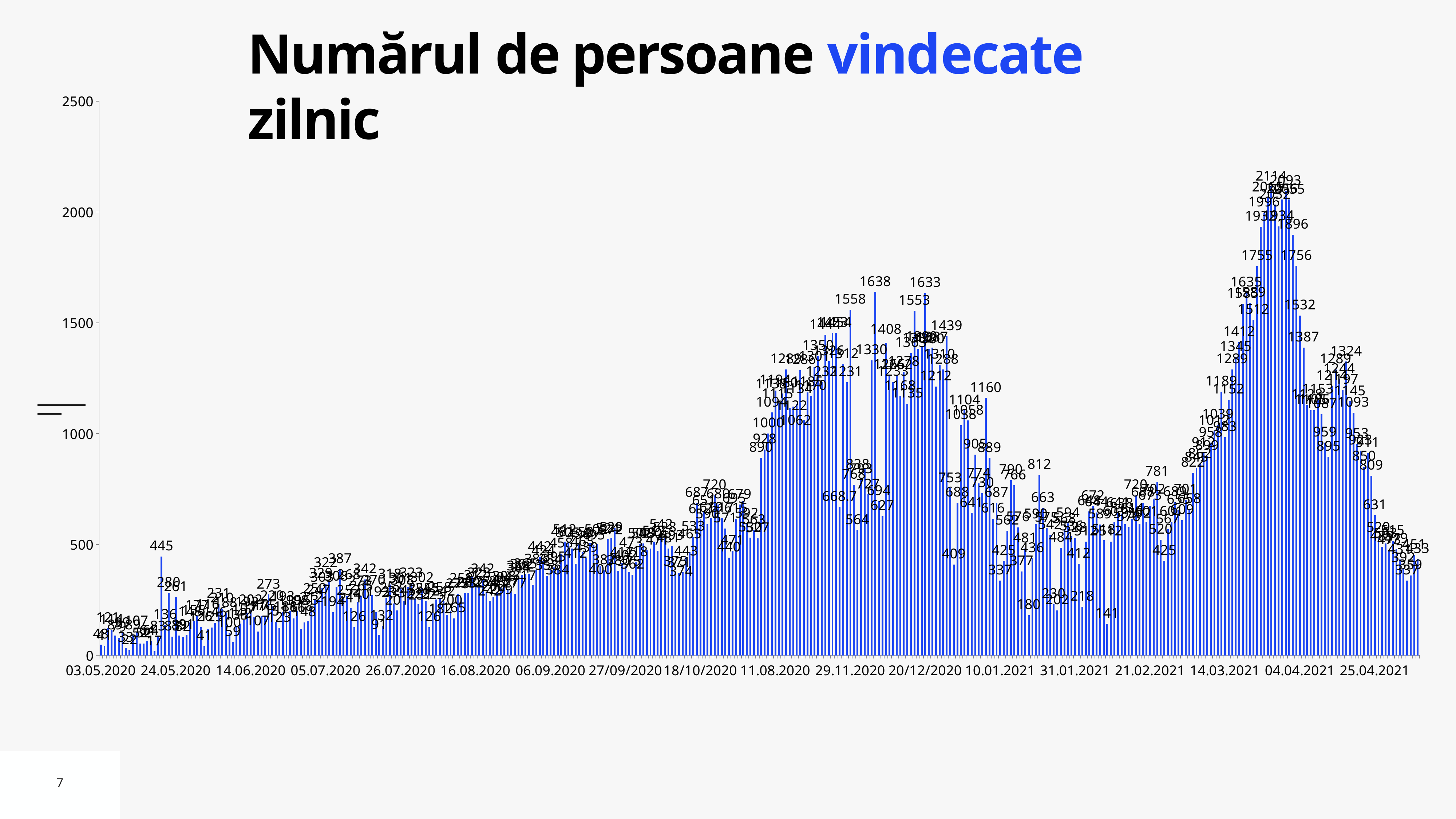
What is the value of the tallest bar in the first small peak near 24.05.2020? 445 What kind of chart is shown on the slide? bar chart What is the highest daily value labelled on the chart? 2114 Is the value for 04.04.2021 greater or less than 1500? greater Is the value for 31.01.2021 greater or less than 1000? less What is the highest value shown on the vertical axis? 2500 Is the value for 03.05.2020 greater or less than 500? less Do the values generally rise or fall between 21.02.2021 and 04.04.2021? rise Do the values generally rise or fall between 04.04.2021 and 25.04.2021? fall What is the title of the chart? Numărul de persoane vindecate zilnic What is the difference between the highest value 2114 and the peak labelled 1638? 476 Which is larger, the peak labelled 1638 or the peak labelled 1633? 1638